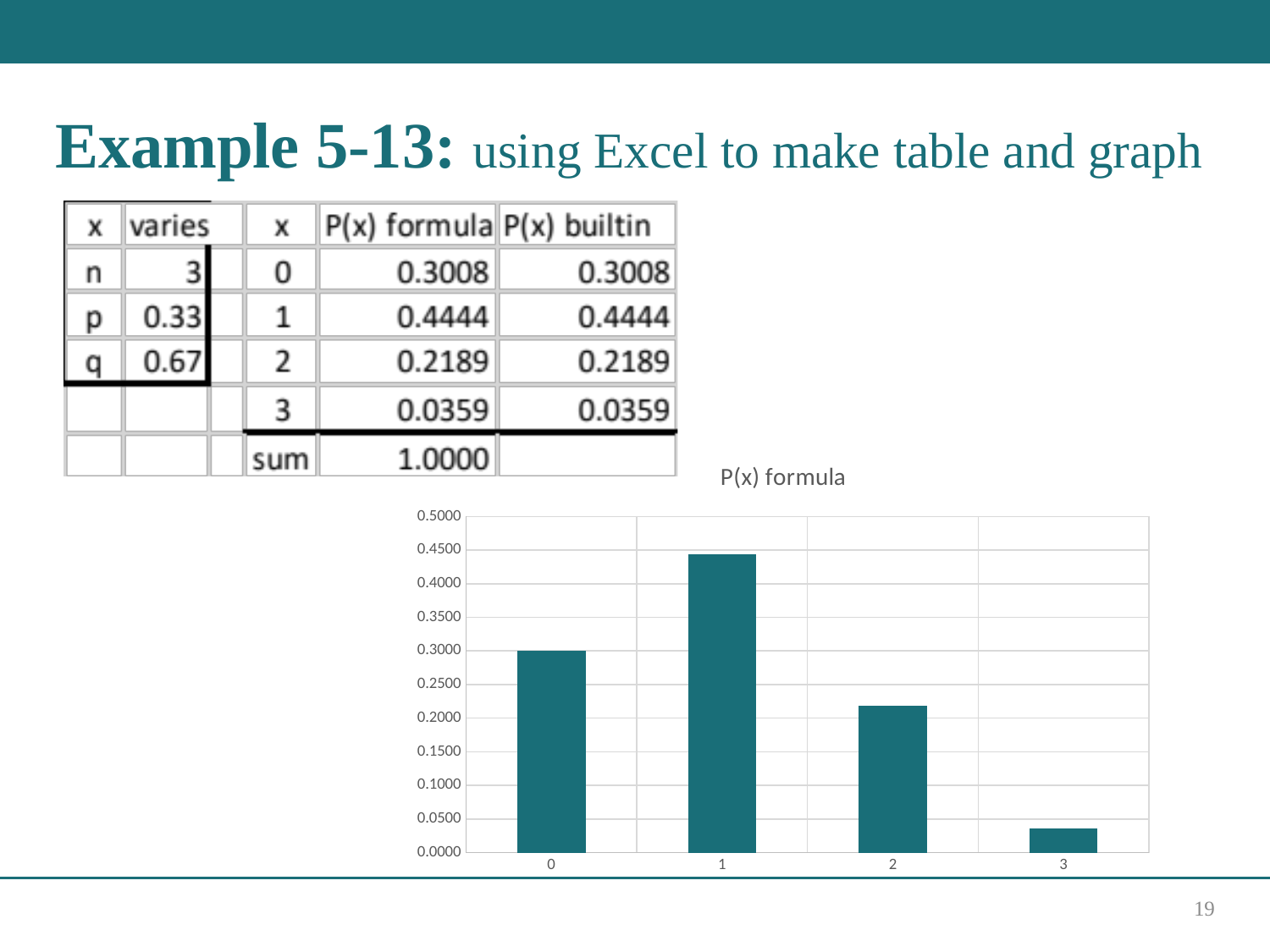
Which bar is taller, the one for x = 0 or the one for x = 2? x = 0 Which x value has the highest bar in the chart? 1 Which x value has the lowest bar in the chart? 3 Is the bar for x = 2 greater or less than 0.2500? less According to the table on the slide, what is the P(x) formula value plotted for x = 1? 0.4444 What kind of chart is shown on the slide? bar chart What is the title of the chart? P(x) formula Is the bar for x = 0 greater or less than 0.2500? greater Is the bar for x = 1 greater or less than 0.4000? greater How many bars does the chart have? 4 Do the bars rise or fall from x = 1 to x = 3? fall